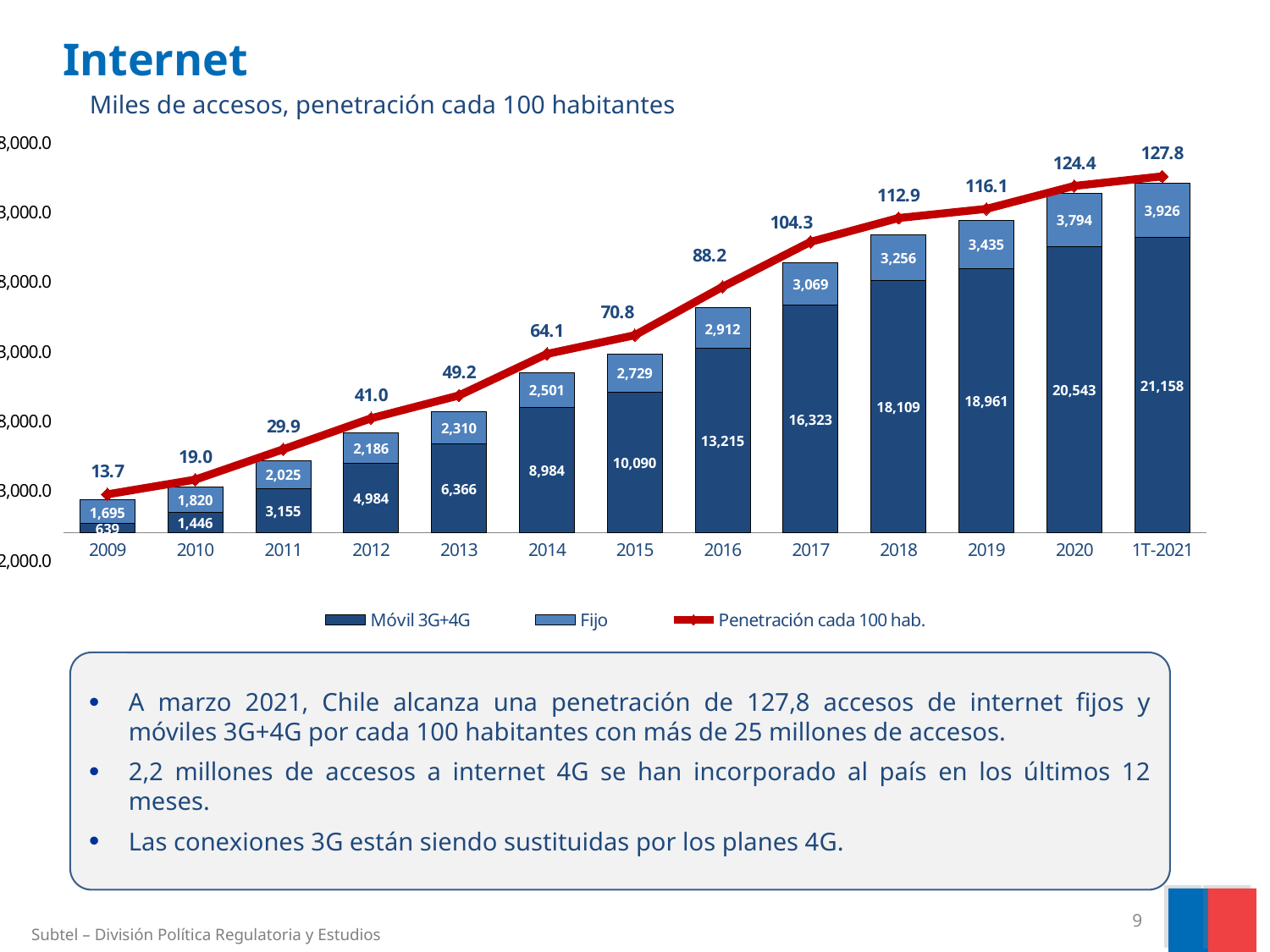
Which year has the highest Penetración cada 100 hab. value? 1T-2021 Does the Penetración cada 100 hab. line rise or fall from 2009 to 1T-2021? Rise What is the Móvil 3G+4G value for 2016? 13,215 Which year has the lowest Móvil 3G+4G value? 2009 How many time periods are shown on the x axis? 13 Which is larger, the Fijo value for 2009 or the Móvil 3G+4G value for 2009? Fijo How many series does the legend list? 3 What is the total of the stacked bar for 2020 (Móvil 3G+4G plus Fijo)? 24,337 What kind of chart is this? Stacked bar chart with a line What is the Penetración cada 100 hab. value for 2014? 64.1 What is the Fijo value for 2019? 3,435 What is the difference between the Móvil 3G+4G values for 1T-2021 and 2020? 615